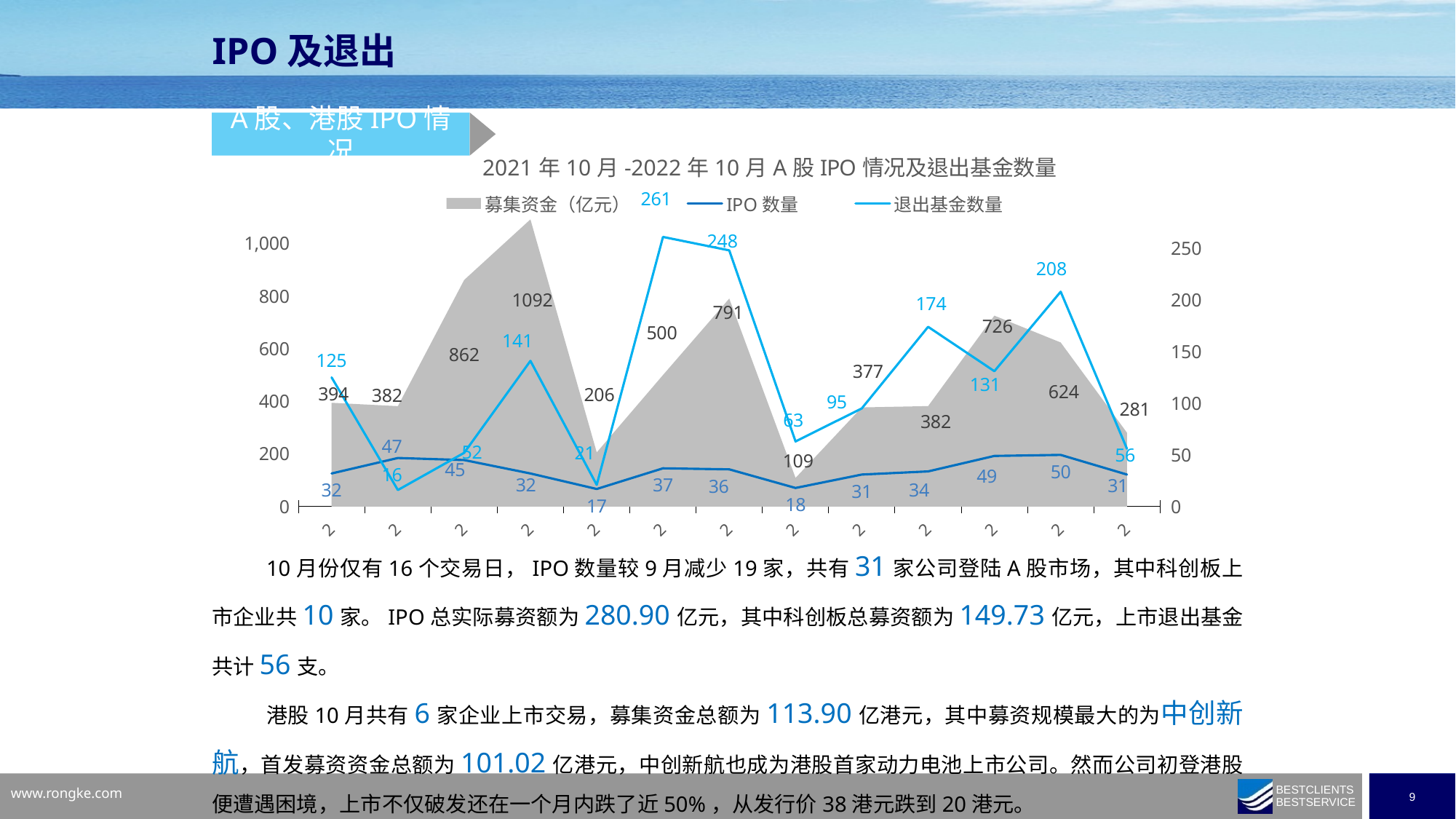
What is the value of the IPO数量 series at the last point on the x axis (October 2022)? 31 What is the lowest value labelled for the 退出基金数量 series? 16 What is the title of the chart? 2021年10月-2022年10月A股IPO情况及退出基金数量 Which series is drawn as a shaded gray area rather than a line? 募集资金（亿元） What is the highest value labelled for the IPO数量 series? 50 How many series does the chart legend list? 3 What is the highest value labelled for the 募集资金（亿元） series? 1092 What is the highest value labelled for the 退出基金数量 series? 261 How many data points does each series in the chart have? 13 What is the difference between the highest 募集资金（亿元） value (1092) and the lowest (109)? 983 What is the value of the 退出基金数量 series at the last point on the x axis (October 2022)? 56 What is the lowest value labelled for the 募集资金（亿元） series? 109